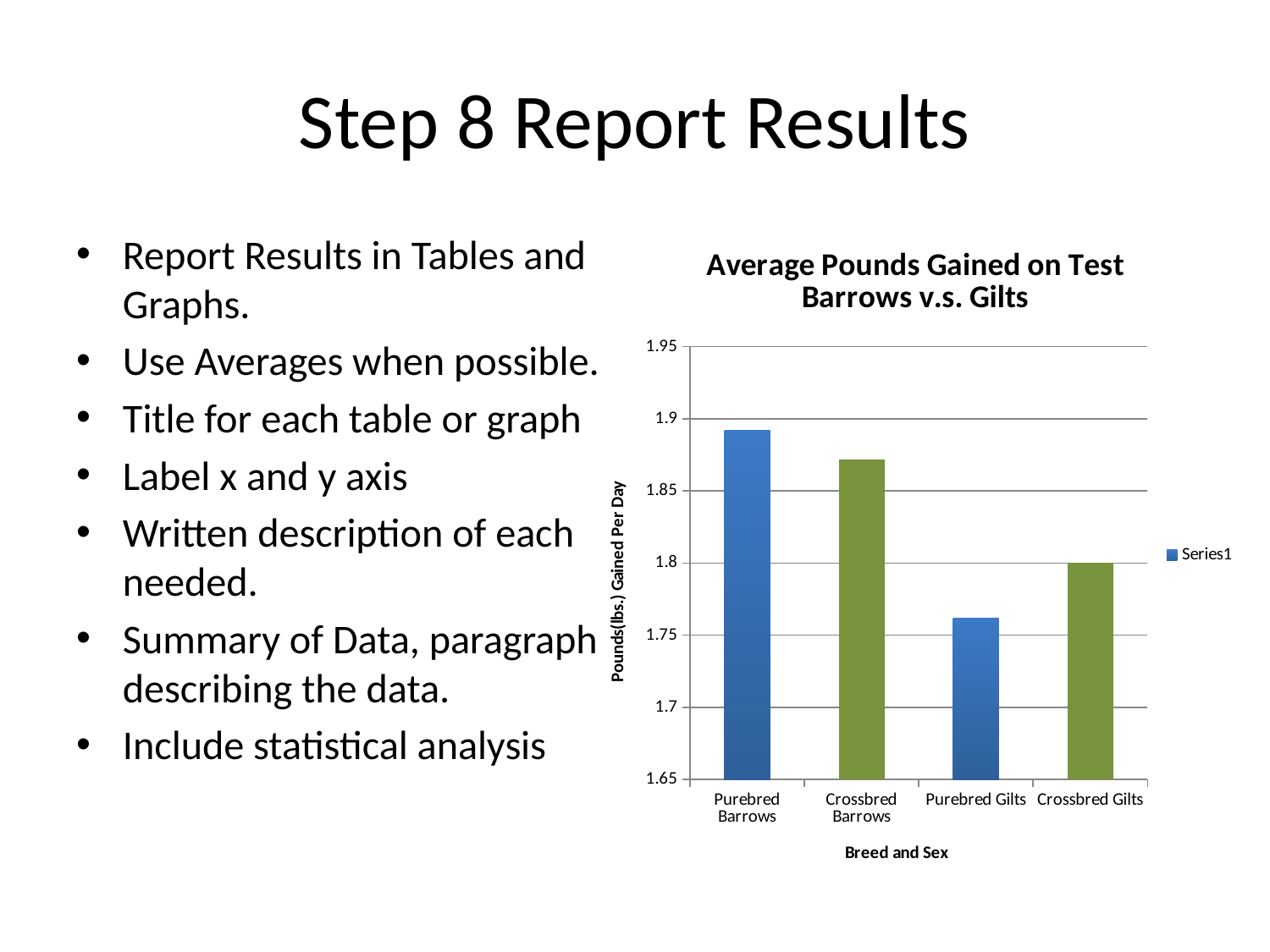
Is the value for Crossbred Barrows greater or less than 1.85? greater What is the title of the chart? Average Pounds Gained on Test Barrows v.s. Gilts Is the value for Purebred Barrows greater or less than 1.85? greater How many series does the chart legend list? 1 How many categories are shown on the x axis of the chart? 4 Which category has the highest value in the chart? Purebred Barrows What is the label of the x axis of the chart? Breed and Sex Which is larger, the value for Purebred Gilts or Crossbred Gilts? Crossbred Gilts What kind of chart is shown on the slide? bar chart Which category has the lowest value in the chart? Purebred Gilts Is the value for Purebred Gilts greater or less than 1.8? less Which is larger, the value for Purebred Barrows or Purebred Gilts? Purebred Barrows